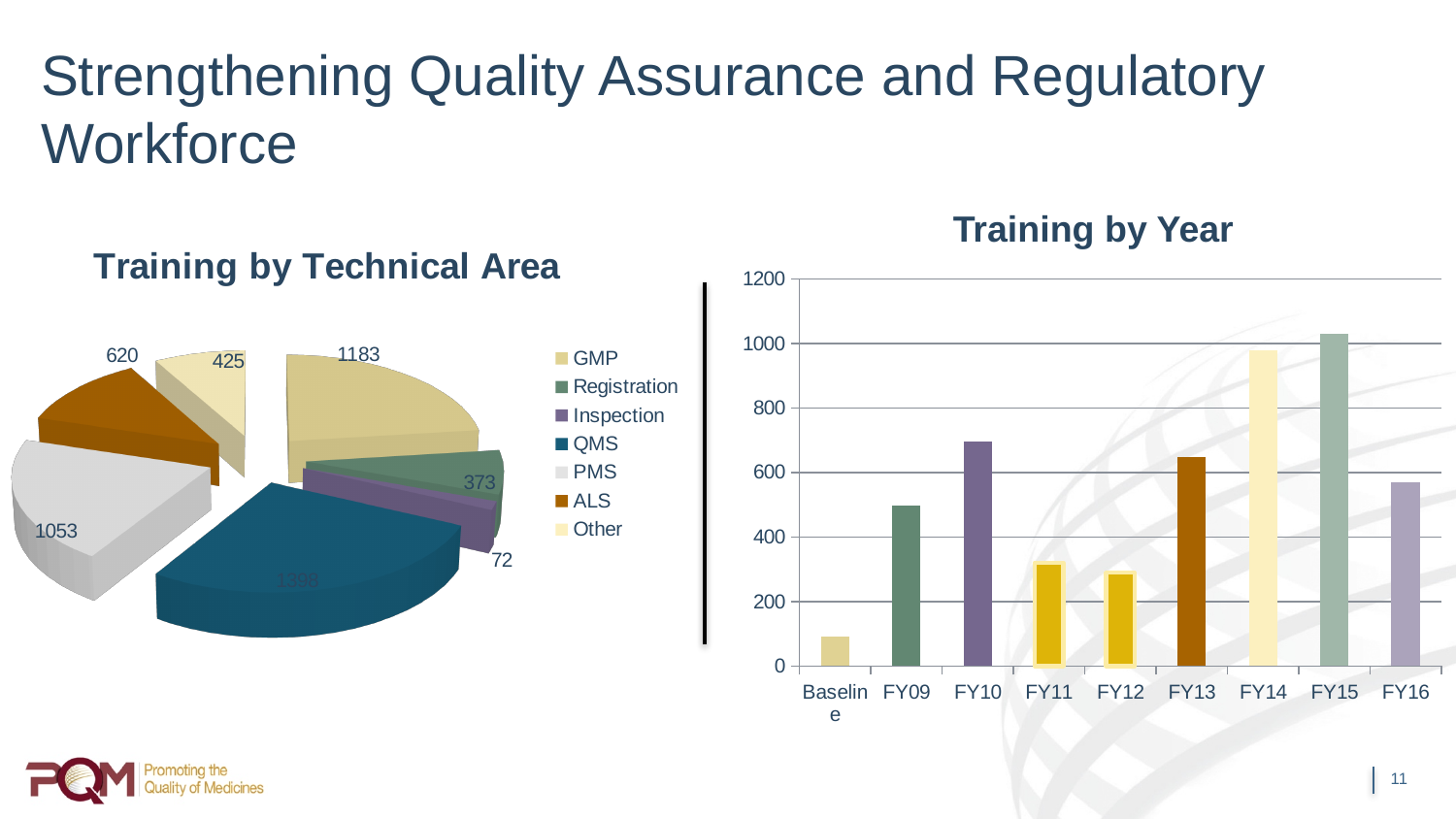
In the Training by Technical Area pie chart, what is the value for PMS? 1053 In the Training by Year chart, is the value for FY10 greater or less than 600? greater In the Training by Year chart, which year has the highest bar? FY15 How many entries does the legend of the Training by Technical Area chart list? 7 What kind of chart is the Training by Year chart? Bar chart In the Training by Technical Area pie chart, which is larger, Registration or ALS? ALS In the Training by Year chart, which category has the lowest bar? Baseline In the Training by Technical Area pie chart, what is the value for QMS? 1398 In the Training by Technical Area pie chart, which technical area has the smallest value? Inspection How many categories are shown on the x axis of the Training by Year chart? 9 In the Training by Technical Area pie chart, what is the difference between the GMP value and the PMS value? 130 In the Training by Technical Area pie chart, which technical area has the largest value? QMS